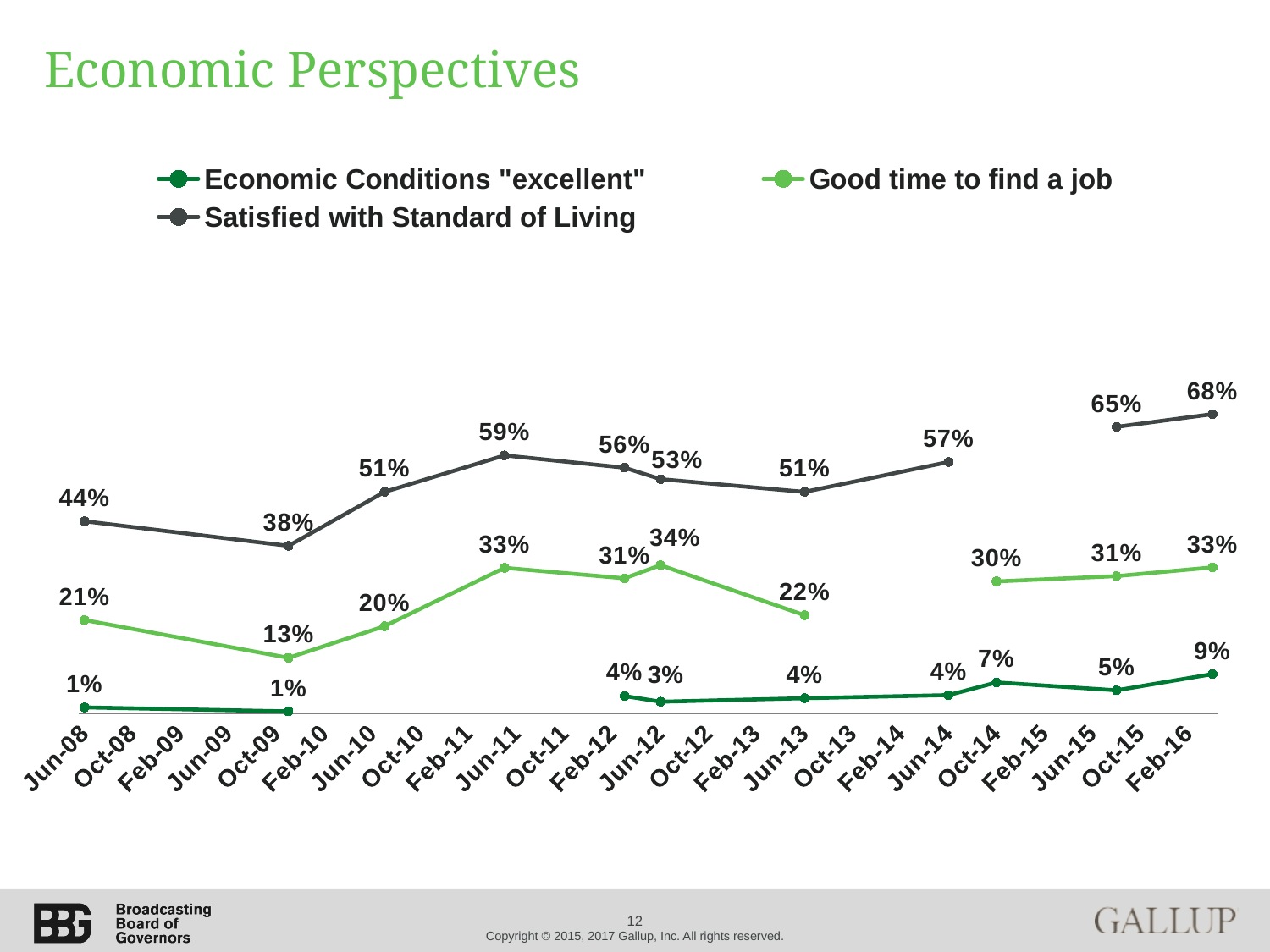
At Feb-16, what is the difference between Satisfied with Standard of Living and Good time to find a job? 35 percentage points How many series does the legend list? 3 What is the highest value shown for Satisfied with Standard of Living? 68% What is the value for Economic Conditions "excellent" at Feb-16? 9% What is the value for Good time to find a job at Jun-08? 21% What is the value for Satisfied with Standard of Living at Jun-11? 59% What kind of chart is shown on the slide? line chart At Jun-08, which is higher: Satisfied with Standard of Living or Good time to find a job? Satisfied with Standard of Living What is the value for Satisfied with Standard of Living at Feb-16? 68% Does the Satisfied with Standard of Living line rise or fall from Jun-13 to Feb-16? rise What is the title of the slide? Economic Perspectives What is the lowest value shown for Good time to find a job? 13%